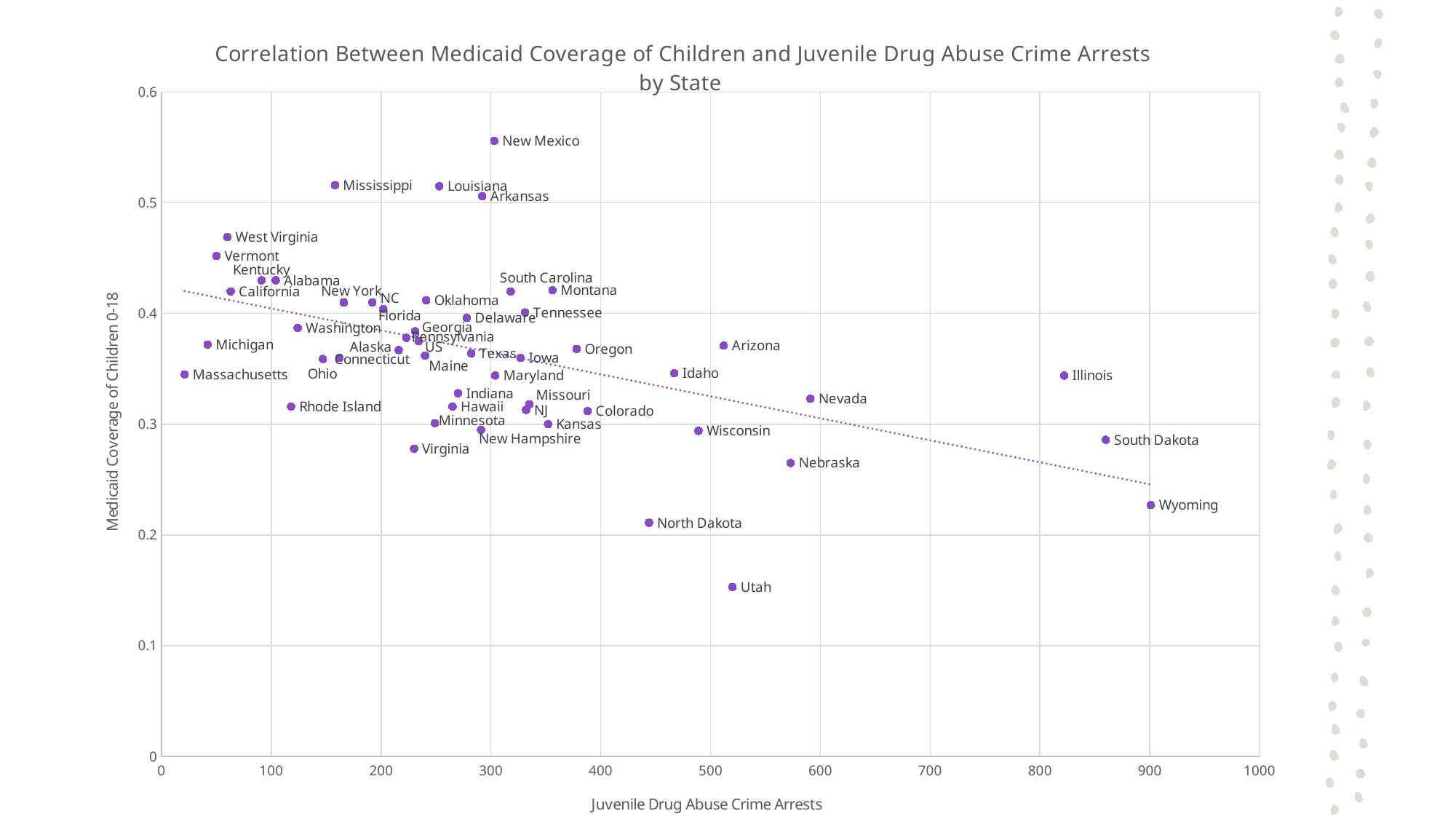
Which state has the lowest Medicaid coverage of children 0-18? Utah Is the juvenile drug abuse crime arrests value for Wyoming greater or less than 800? greater Which state has the highest Medicaid coverage of children 0-18? New Mexico Does Medicaid coverage of children tend to rise or fall as juvenile drug abuse crime arrests increase, according to the trend line? Fall Which state has the highest number of juvenile drug abuse crime arrests? Wyoming Is the Medicaid coverage value for New Mexico greater or less than 0.5? greater Is the Medicaid coverage value for North Dakota greater or less than 0.3? less Which state has higher Medicaid coverage of children, Mississippi or Utah? Mississippi What kind of chart is shown on the slide? Scatter plot What is the label of the y axis? Medicaid Coverage of Children 0-18 Which state has the lowest number of juvenile drug abuse crime arrests? Massachusetts